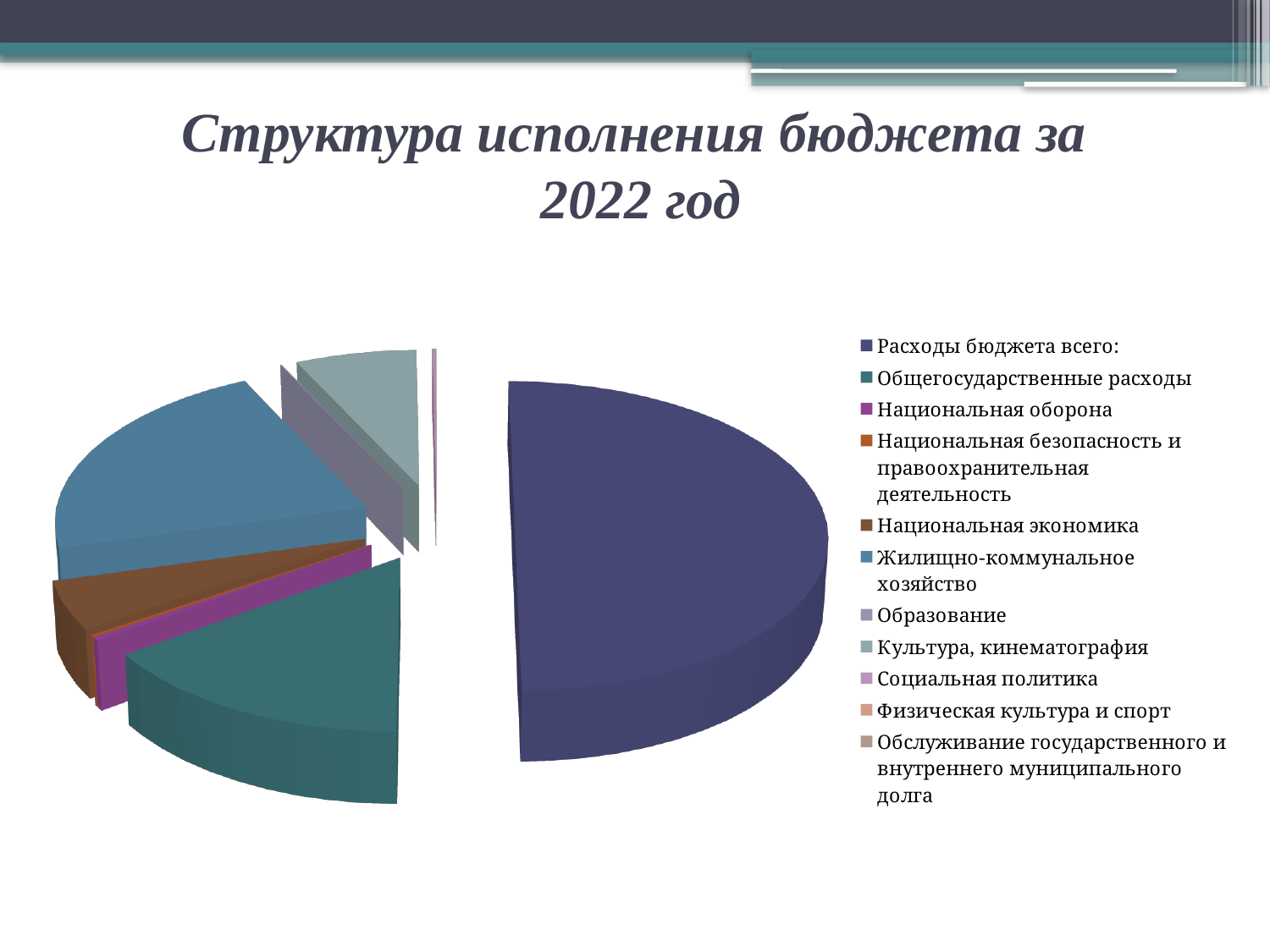
Which slice is larger: Жилищно-коммунальное хозяйство or Национальная экономика? Жилищно-коммунальное хозяйство What is the title of the chart on the slide? Структура исполнения бюджета за 2022 год Which slice is larger: Расходы бюджета всего or Жилищно-коммунальное хозяйство? Расходы бюджета всего: What kind of chart is shown on the slide? pie chart Which legend entry is listed first in the pie chart's legend? Расходы бюджета всего: Which slice is larger: Культура, кинематография or Образование? Культура, кинематография Which category has the largest slice in the pie chart? Расходы бюджета всего: How many categories does the legend of the pie chart list? 11